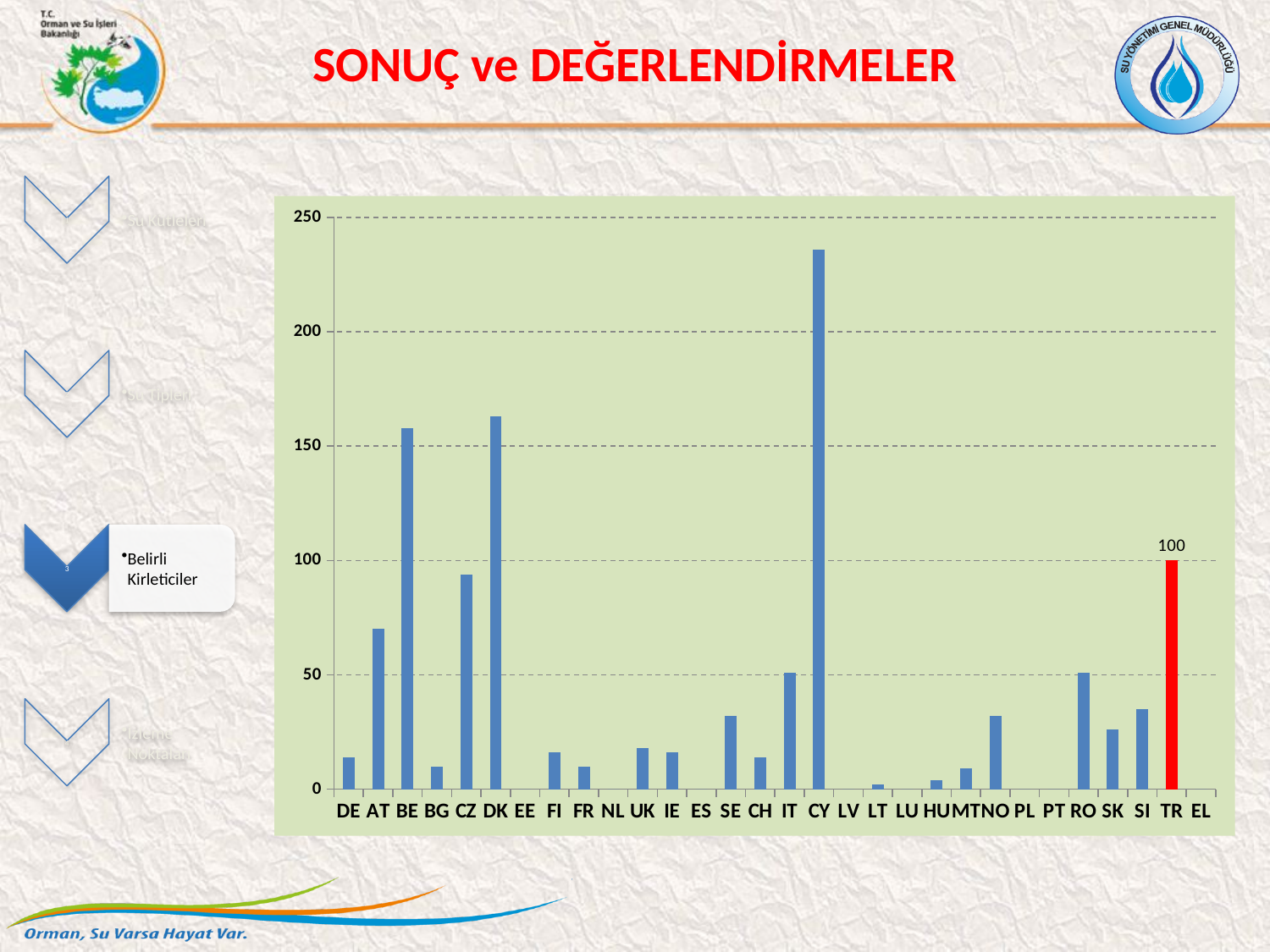
Which is larger, the value for CZ or the value for AT? CZ Is the value for BE greater or less than 150? greater Is the value for SE greater or less than 50? less Which is larger, the value for CY or the value for BE? CY Is the value for CY greater or less than 200? greater How many countries are shown on the x axis? 30 What kind of chart is shown on the slide? bar chart Which country's bar is coloured red instead of blue? TR Which country has the highest bar? CY What is the value for TR? 100